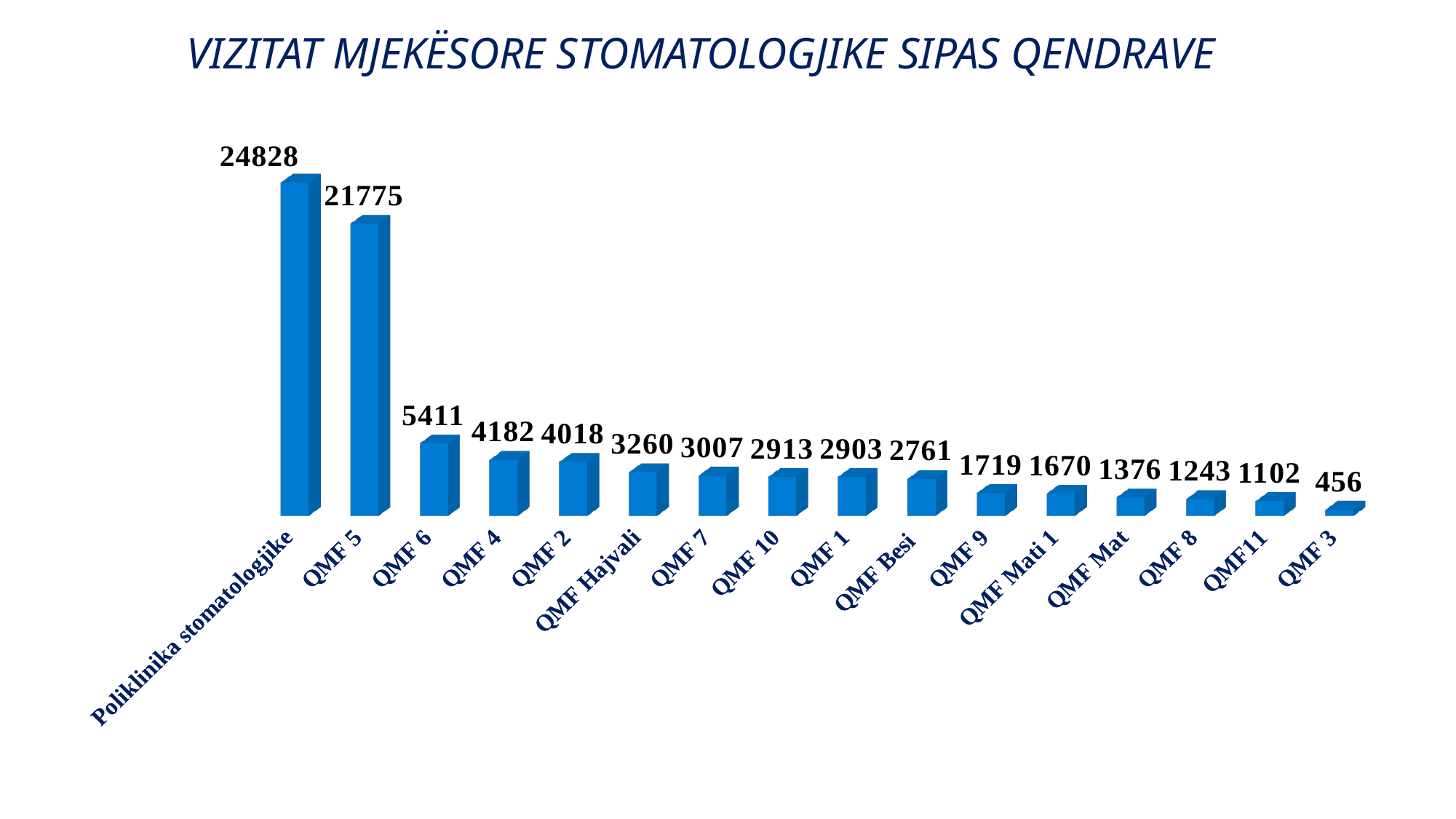
What is the difference between the values for QMF 6 and QMF 4? 1229 Which category has the highest value? Poliklinika stomatologjike Which category has the lowest value? QMF 3 How many categories are shown in the chart? 16 What is the value for QMF Hajvali? 3260 Which is larger, the value for QMF 8 or the value for QMF Mat? QMF Mat What is the title of the chart? VIZITAT MJEKËSORE STOMATOLOGJIKE SIPAS QENDRAVE What kind of chart is shown on the slide? Bar chart What is the difference between the values for Poliklinika stomatologjike and QMF 5? 3053 What is the value for QMF 5? 21775 Which is larger, the value for QMF 2 or the value for QMF 7? QMF 2 What is the value for QMF Mati 1? 1670